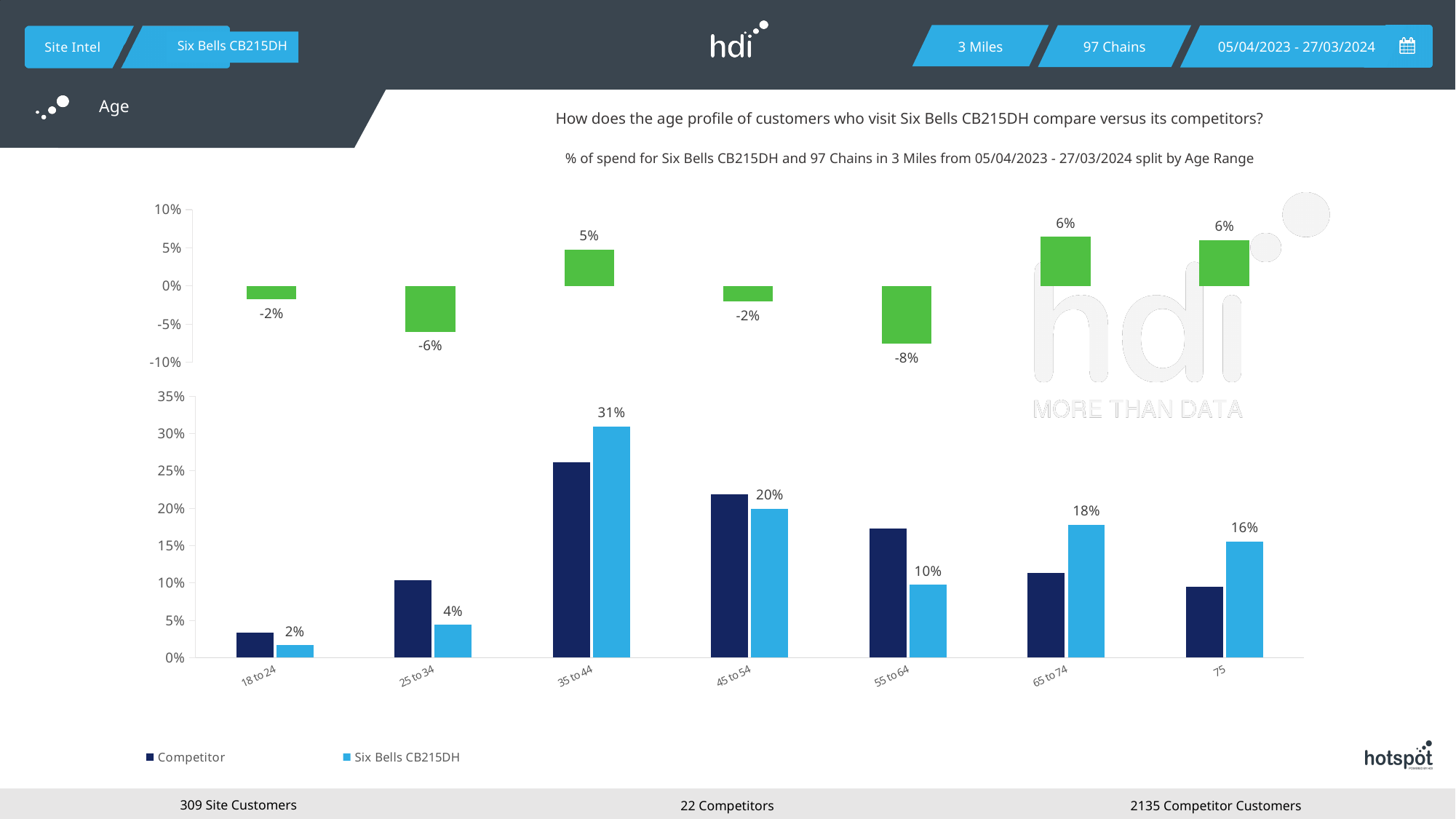
In the bottom chart, for the 45 to 54 age range, which series has the larger value, Competitor or Six Bells CB215DH? Competitor In the top chart, what is the value shown for the 55 to 64 age range? -8% In the top chart, which age range has the lowest value? 55 to 64 In the bottom chart, is the Competitor value for 35 to 44 greater or less than 25%? greater In the bottom chart, which age range has the lowest value for Six Bells CB215DH? 18 to 24 In the bottom chart, what is the difference between the Six Bells CB215DH values for 35 to 44 and 45 to 54? 11% In the bottom chart, what is the value for Six Bells CB215DH in the 35 to 44 age range? 31% In the bottom chart, what is the value for Six Bells CB215DH in the 65 to 74 age range? 18% In the top chart, what is the value shown for the 25 to 34 age range? -6% In the bottom chart, which age range has the highest value for Six Bells CB215DH? 35 to 44 How many series does the legend of the bottom chart list? 2 How many age range categories are shown on the x axis of the bottom chart? 7